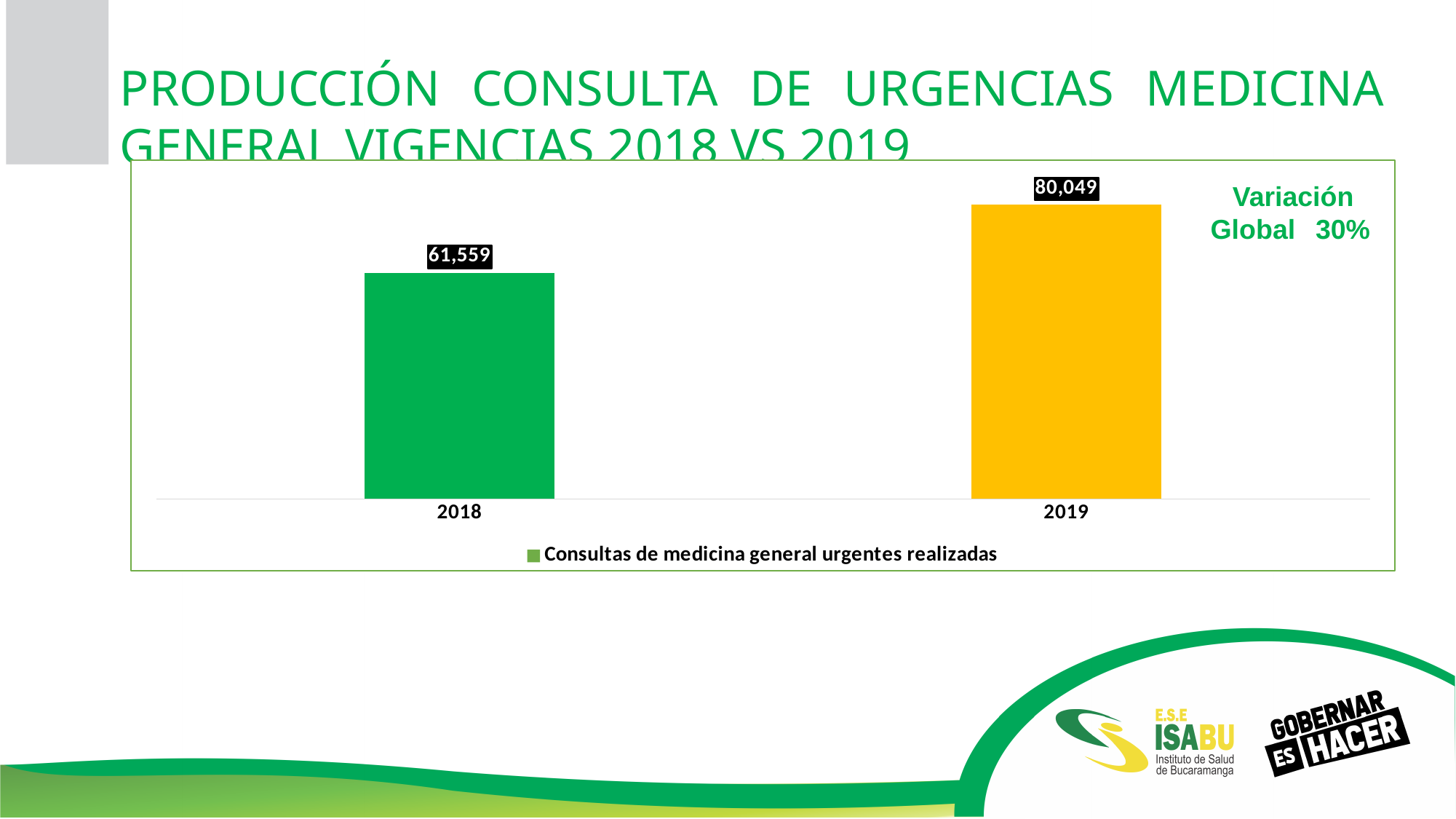
What is the value for 2018? 61,559 How many categories are shown on the x axis? 2 Which year has the lowest value? 2018 What is the value for 2019? 80,049 What is the series name shown in the legend? Consultas de medicina general urgentes realizadas Which is larger, the value for 2018 or the value for 2019? 2019 What global variation percentage is stated on the chart? 30% How many series does the legend list? 1 Which year has the highest value? 2019 Do the values rise or fall from 2018 to 2019? rise What is the difference between the values for 2019 and 2018? 18,490 What kind of chart is shown? bar chart